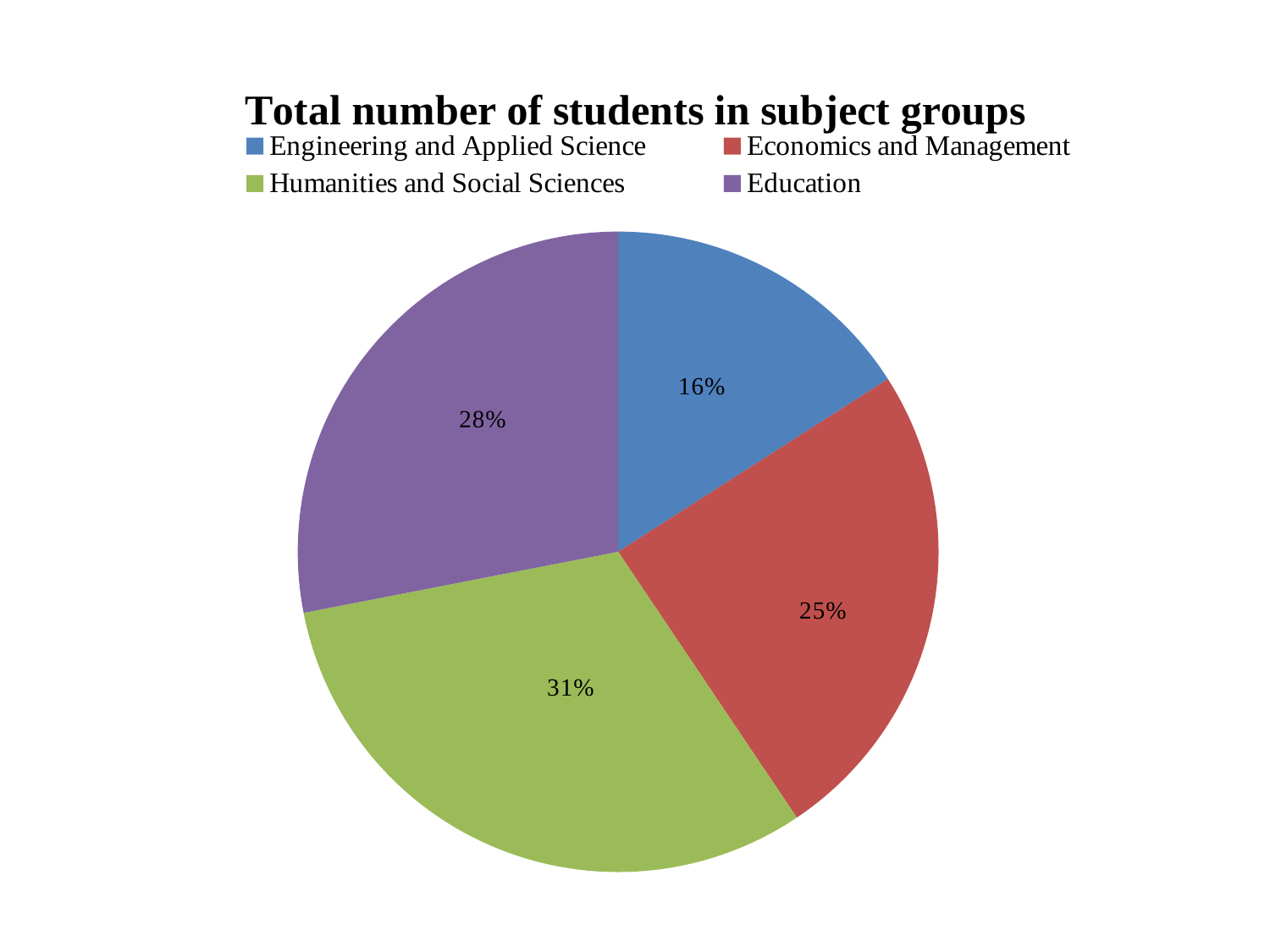
Which subject group has the smallest share of students? Engineering and Applied Science What percentage of students are in Education? 28% What kind of chart is shown on the slide? Pie chart What colour is the slice for Education? Purple How many subject groups are shown in the pie chart? 4 What is the title of the chart? Total number of students in subject groups What is the difference in percentage points between Humanities and Social Sciences and Engineering and Applied Science? 15 What percentage of students are in Humanities and Social Sciences? 31% Which subject group has the largest share of students? Humanities and Social Sciences What percentage of students are in Engineering and Applied Science? 16% Which has a larger share, Education or Economics and Management? Education What percentage of students are in Economics and Management? 25%